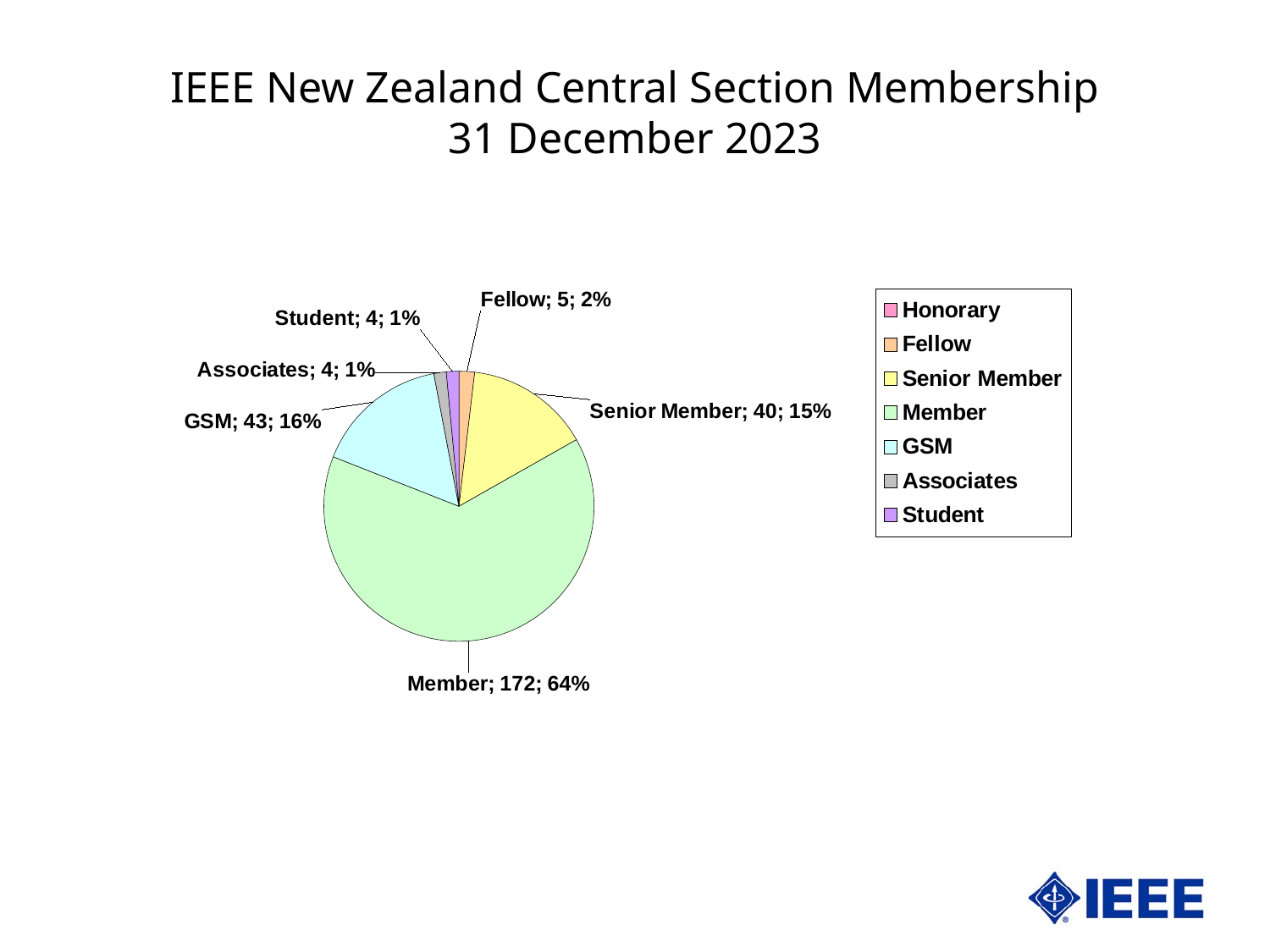
What is the title of the slide containing the chart? IEEE New Zealand Central Section Membership 31 December 2023 What share of the pie does the GSM category represent? 16% How many members are in the GSM category? 43 How many members are in the Fellow category? 5 Which is larger, the GSM count or the Senior Member count? GSM What share of the pie does the Member category represent? 64% How many entries does the legend list? 7 What kind of chart is shown on the slide? Pie chart Which category has the largest slice of the pie? Member How many members are in the Member category? 172 What is the difference between the Member count and the GSM count? 129 How many members are in the Senior Member category? 40